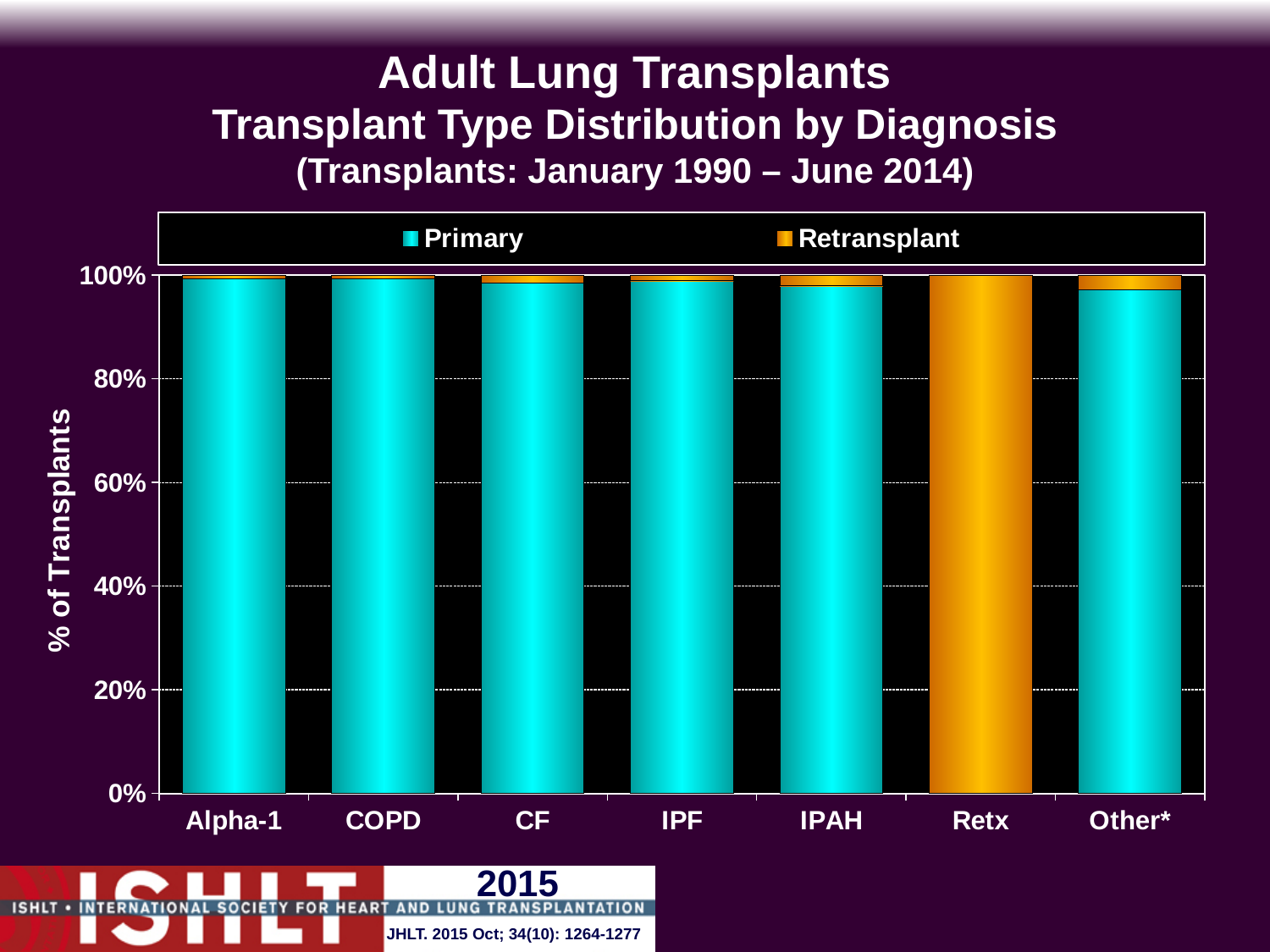
What is the Retransplant share for Retx? 100% How many diagnosis categories are shown on the x axis? 7 Which category has the lowest Primary share? Retx Is the Primary share for Alpha-1 greater or less than 80%? greater What is the label on the y axis? % of Transplants Which category has the highest Retransplant share? Retx How many series does the legend list? 2 What kind of chart is shown on the slide? bar chart Which has a larger Primary share, Alpha-1 or Retx? Alpha-1 Is the Primary share for Other* greater or less than 60%? greater Is the Retransplant share for COPD greater or less than 20%? less Which series is shown in orange according to the legend? Retransplant